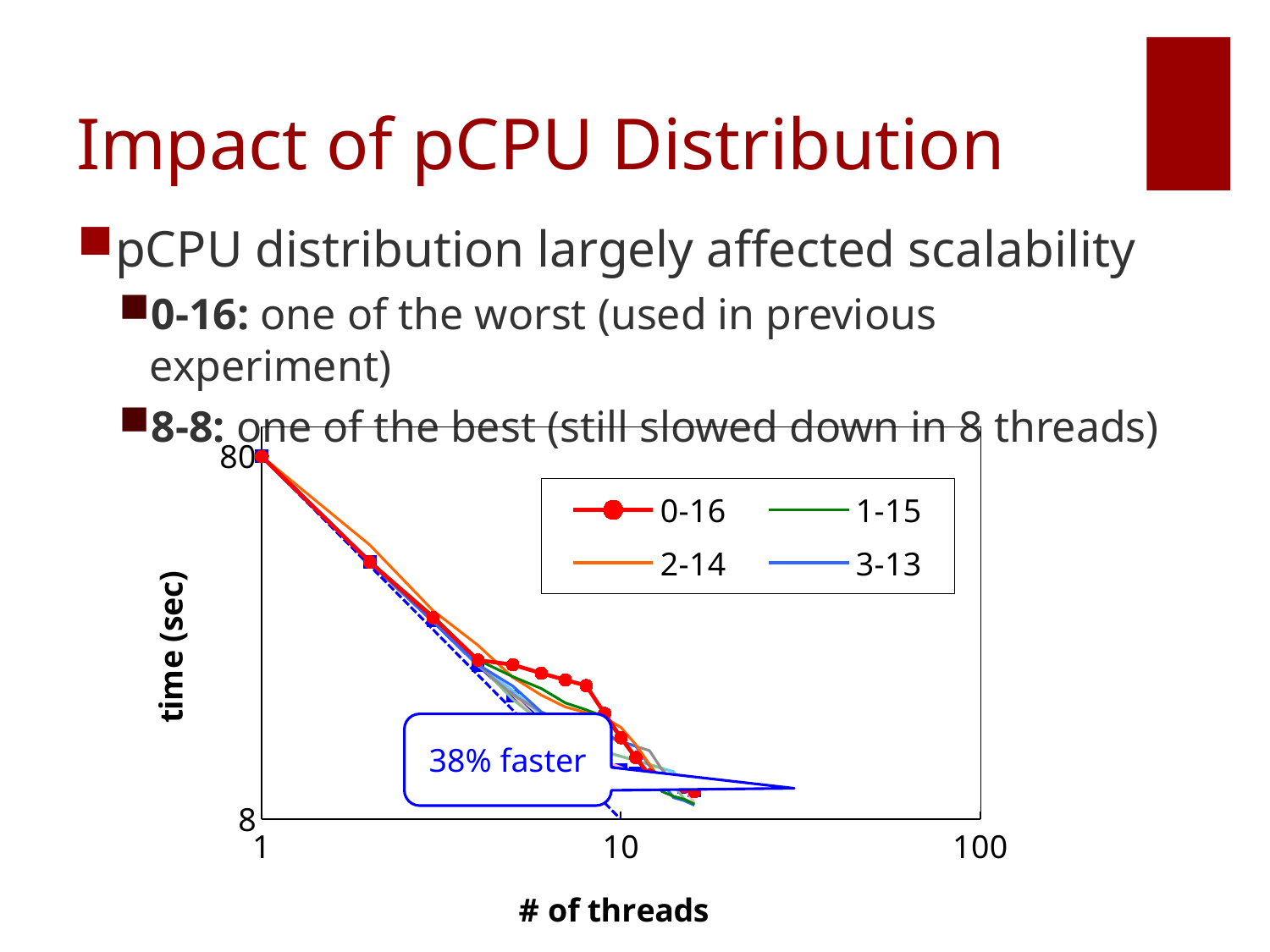
How many series does the chart's legend list? 4 What is the label of the x axis of the chart? # of threads Is the time for the 0-16 series at 10 threads greater or less than 8? greater Which series has the highest time at around 8 threads? 0-16 What is the label of the y axis of the chart? time (sec) Which series is drawn with circular markers in the chart? 0-16 Is the time for the 2-14 series at 2 threads greater or less than 80? less At around 7 threads, which series has the higher time, 0-16 or 1-15? 0-16 Do the time values rise or fall as the number of threads increases? fall What kind of chart is shown on the slide? line chart